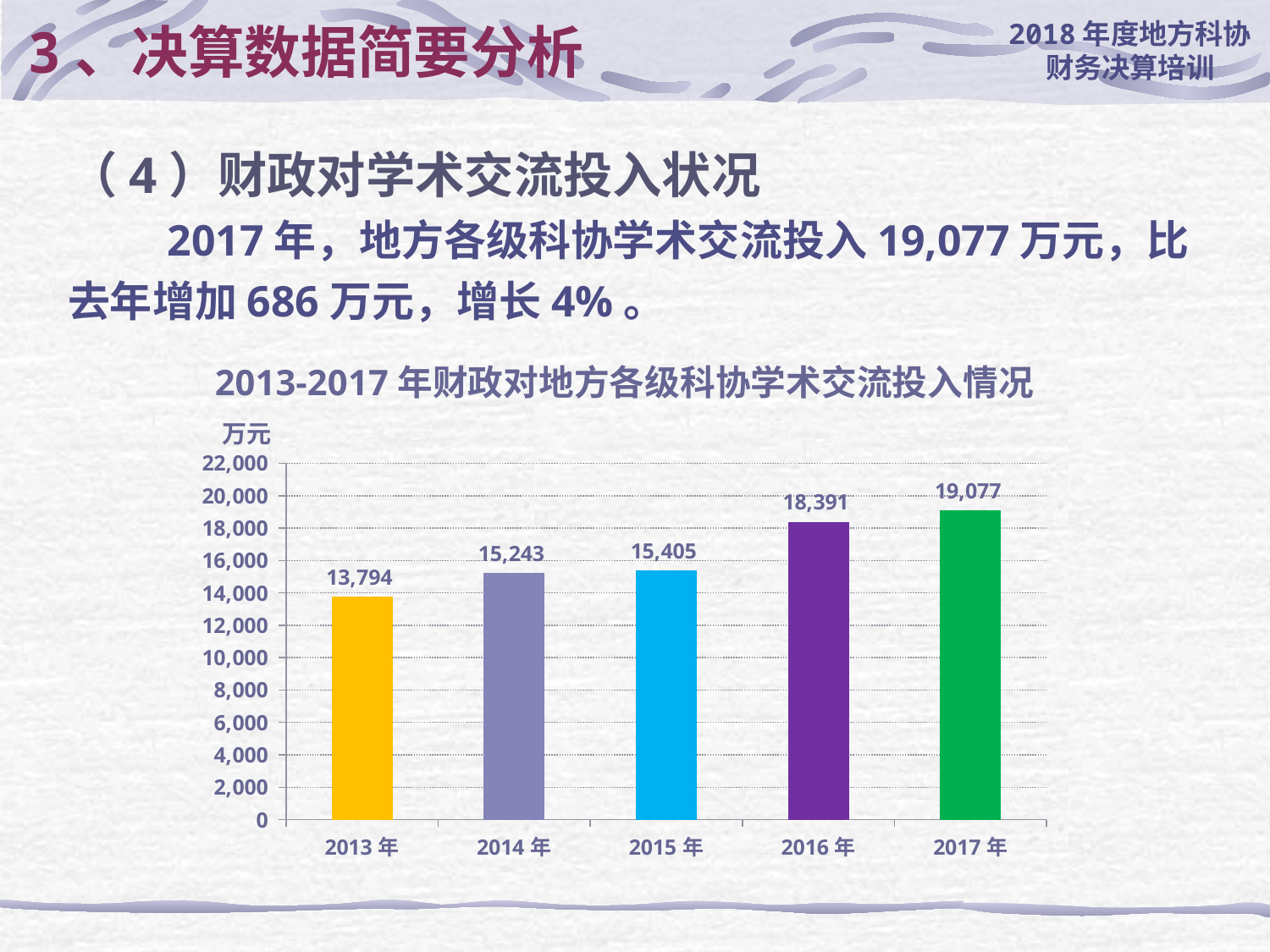
What is the value for 2017年? 19,077 Which year has the highest value? 2017年 How many years are shown on the x axis? 5 Is the value for 2015年 greater or less than 16,000? less What is the difference between the values for 2017年 and 2016年? 686 What is the difference between the values for 2014年 and 2013年? 1,449 Do the values rise or fall from 2013年 to 2017年? rise What is the value for 2013年? 13,794 Which is larger, the value for 2016年 or the value for 2015年? 2016年 What kind of chart is shown? bar chart What is the value for 2016年? 18,391 Which year has the lowest value? 2013年